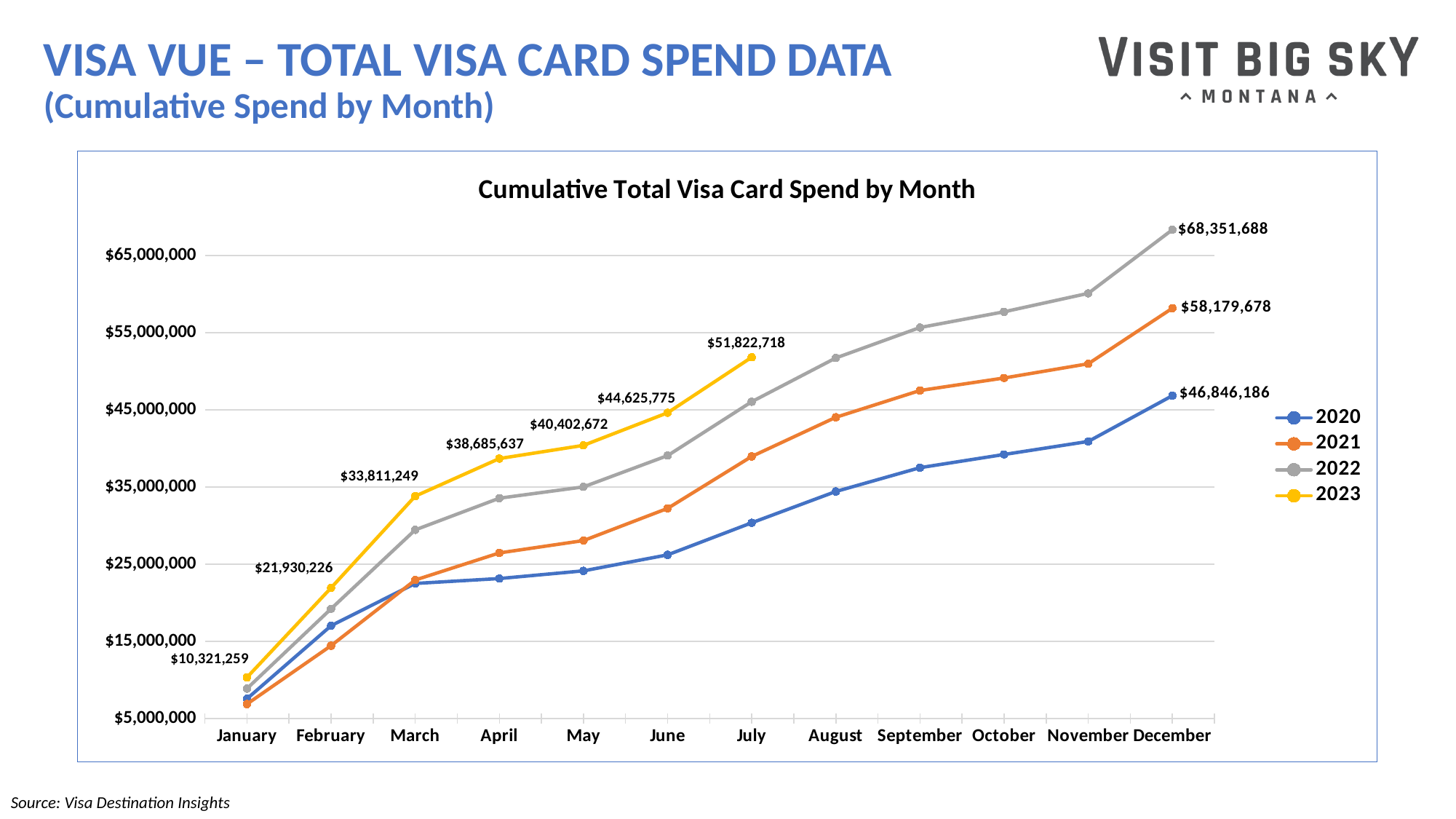
Does the 2023 line rise or fall from January to July? rise What kind of chart is shown on the slide? line chart What is the cumulative spend for 2023 in January? $10,321,259 How many series does the legend list? 4 What is the cumulative spend for 2020 in December? $46,846,186 What is the difference between the December values for 2022 and 2021? $10,172,010 What is the cumulative spend for 2022 in December? $68,351,688 Which year has the highest cumulative spend in December? 2022 Is the value for 2020 in September greater or less than $35,000,000? greater How much did the 2023 cumulative spend increase from June to July? $7,196,943 What is the cumulative spend for 2023 in July? $51,822,718 How many months are shown on the x axis? 12